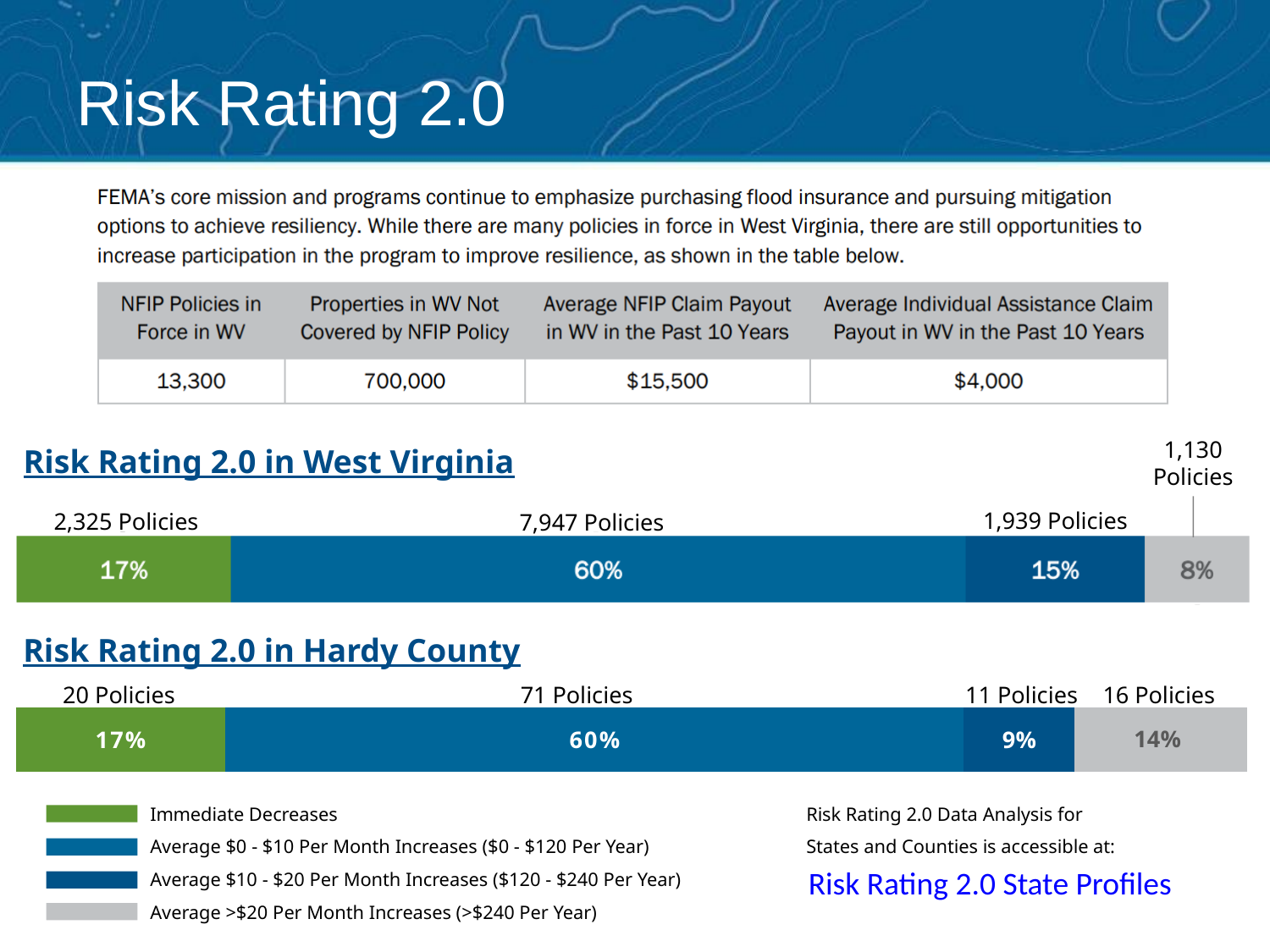
In the Risk Rating 2.0 in Hardy County chart, what is the total number of policies across all four segments? 118 How many segments does each Risk Rating 2.0 bar on the slide contain? 4 In the Risk Rating 2.0 in West Virginia chart, what percentage of policies fall in the Immediate Decreases segment? 17% In the Risk Rating 2.0 in Hardy County chart, which segment has more policies: Immediate Decreases or Average >$20 Per Month Increases? Immediate Decreases In the Risk Rating 2.0 in West Virginia chart, how many policies are in the Average $0 - $10 Per Month Increases segment? 7,947 Policies In the Risk Rating 2.0 in West Virginia chart, which segment has the largest share of policies? Average $0 - $10 Per Month Increases In the Risk Rating 2.0 in Hardy County chart, which segment has the smallest share of policies? Average $10 - $20 Per Month Increases In the Risk Rating 2.0 in Hardy County chart, what percentage of policies fall in the Average >$20 Per Month Increases segment? 14% Which colour represents the Immediate Decreases segment in the Risk Rating 2.0 charts? Green What kind of chart is used for Risk Rating 2.0 in West Virginia and Hardy County? Stacked bar chart In the Risk Rating 2.0 in West Virginia chart, what is the difference in policy count between the Immediate Decreases segment and the Average $10 - $20 Per Month Increases segment? 386 In the Risk Rating 2.0 in Hardy County chart, how many policies are in the Average $10 - $20 Per Month Increases segment? 11 Policies